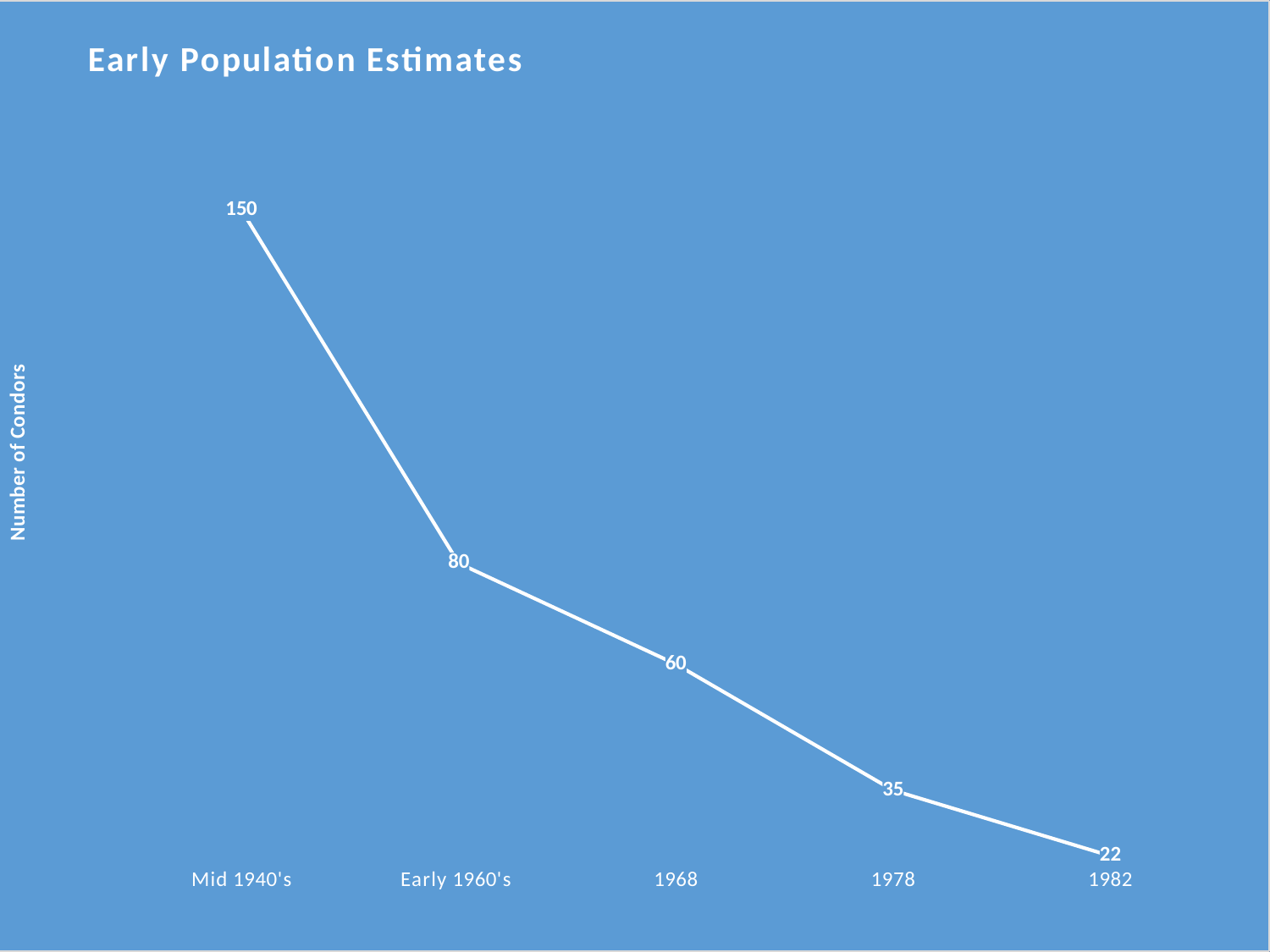
What is the label of the vertical axis? Number of Condors What is the number of condors estimated for 1978? 35 Which period has the highest estimated number of condors? Mid 1940's How many data points are plotted on the chart? 5 What is the number of condors estimated for the Mid 1940's? 150 Which year has the lowest estimated number of condors? 1982 What is the difference between the estimates for 1968 and 1978? 25 What kind of chart is shown on the slide? Line chart What is the difference between the estimates for the Mid 1940's and the Early 1960's? 70 Do the values rise or fall along the x axis from the Mid 1940's to 1982? Fall Which has a higher estimate, the Early 1960's or 1968? Early 1960's What is the number of condors estimated for 1982? 22